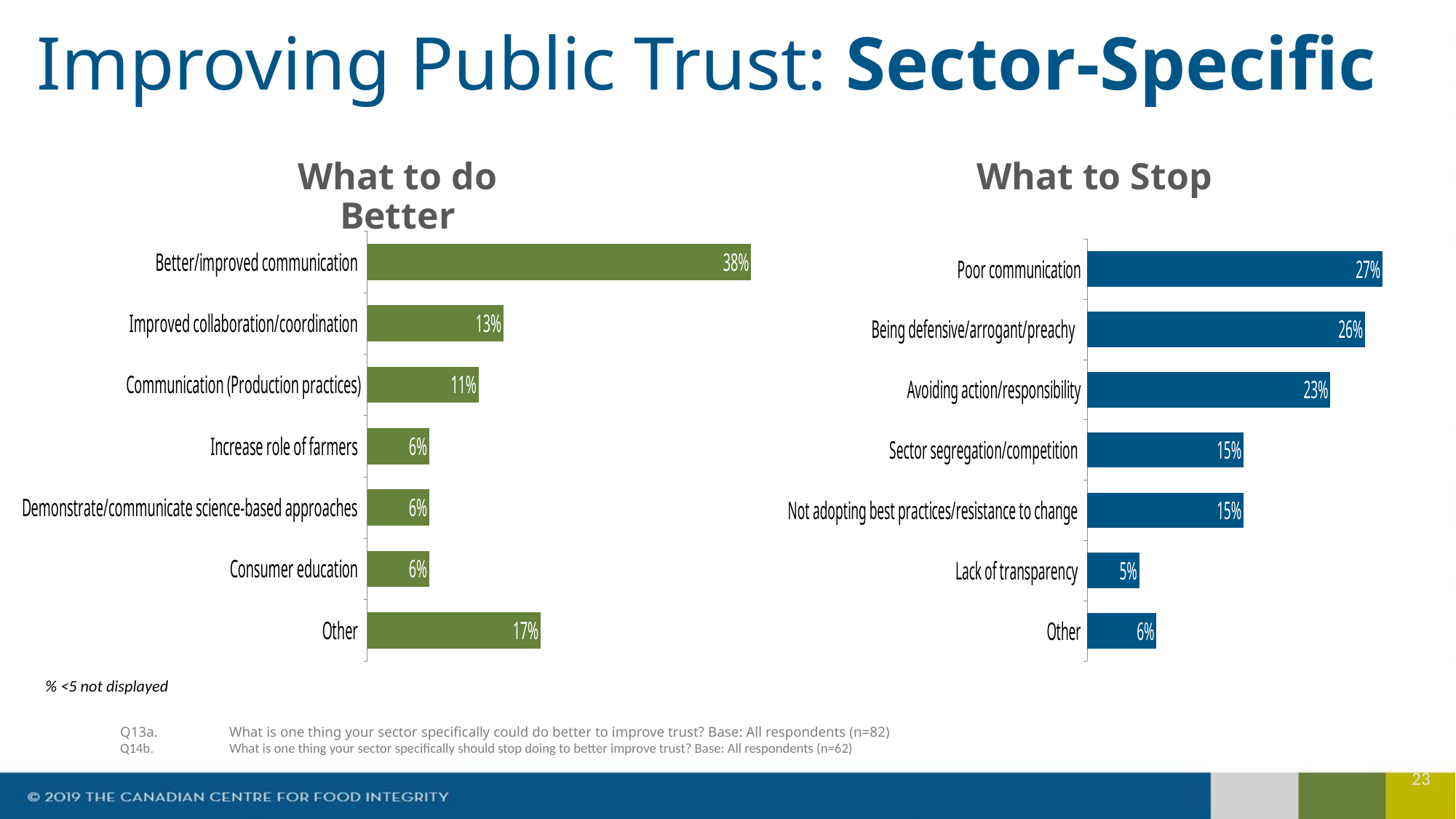
In the 'What to Stop' chart, what is the value for Avoiding action/responsibility? 23% In the 'What to do Better' chart, which category has the highest value? Better/improved communication In the 'What to Stop' chart, what is the difference between Poor communication and Sector segregation/competition? 12% In the 'What to do Better' chart, what is the difference between Better/improved communication and Improved collaboration/coordination? 25% In the 'What to Stop' chart, what is the value for Other? 6% How many categories are shown in the 'What to do Better' chart? 7 In the 'What to Stop' chart, which category has the lowest value? Lack of transparency In the 'What to do Better' chart, what is the value for Better/improved communication? 38% In the 'What to Stop' chart, which is larger: Avoiding action/responsibility or Not adopting best practices/resistance to change? Avoiding action/responsibility How many categories are shown in the 'What to Stop' chart? 7 What kind of chart is the 'What to Stop' chart? Bar chart In the 'What to do Better' chart, which is larger: Other or Communication (Production practices)? Other